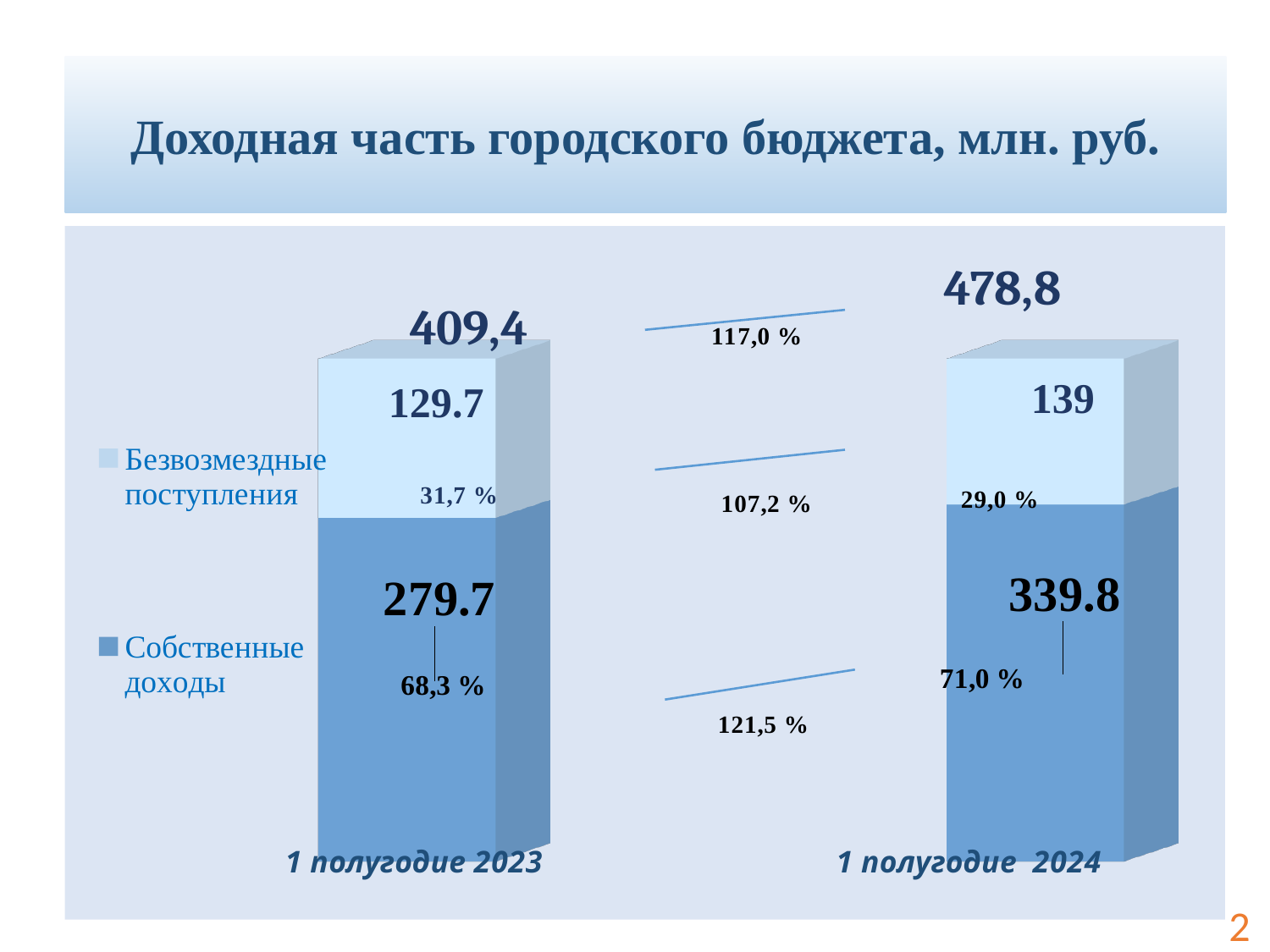
What is the total shown above the bar for 1 полугодие 2024? 478,8 What type of chart is shown on the slide? stacked bar chart Which period has the larger value for Собственные доходы, 1 полугодие 2023 or 1 полугодие 2024? 1 полугодие 2024 What is the title of the chart? Доходная часть городского бюджета, млн. руб. What percentage share of the 1 полугодие 2024 bar is labelled for Собственные доходы? 71,0 % What is the value of Безвозмездные поступления for 1 полугодие 2023? 129.7 What is the total shown above the bar for 1 полугодие 2023? 409,4 What is the value of Собственные доходы for 1 полугодие 2024? 339.8 How many series does the legend list? 2 What is the value of Безвозмездные поступления for 1 полугодие 2024? 139 What is the value of Собственные доходы for 1 полугодие 2023? 279.7 What is the difference between Собственные доходы in 1 полугодие 2024 and 1 полугодие 2023? 60.1